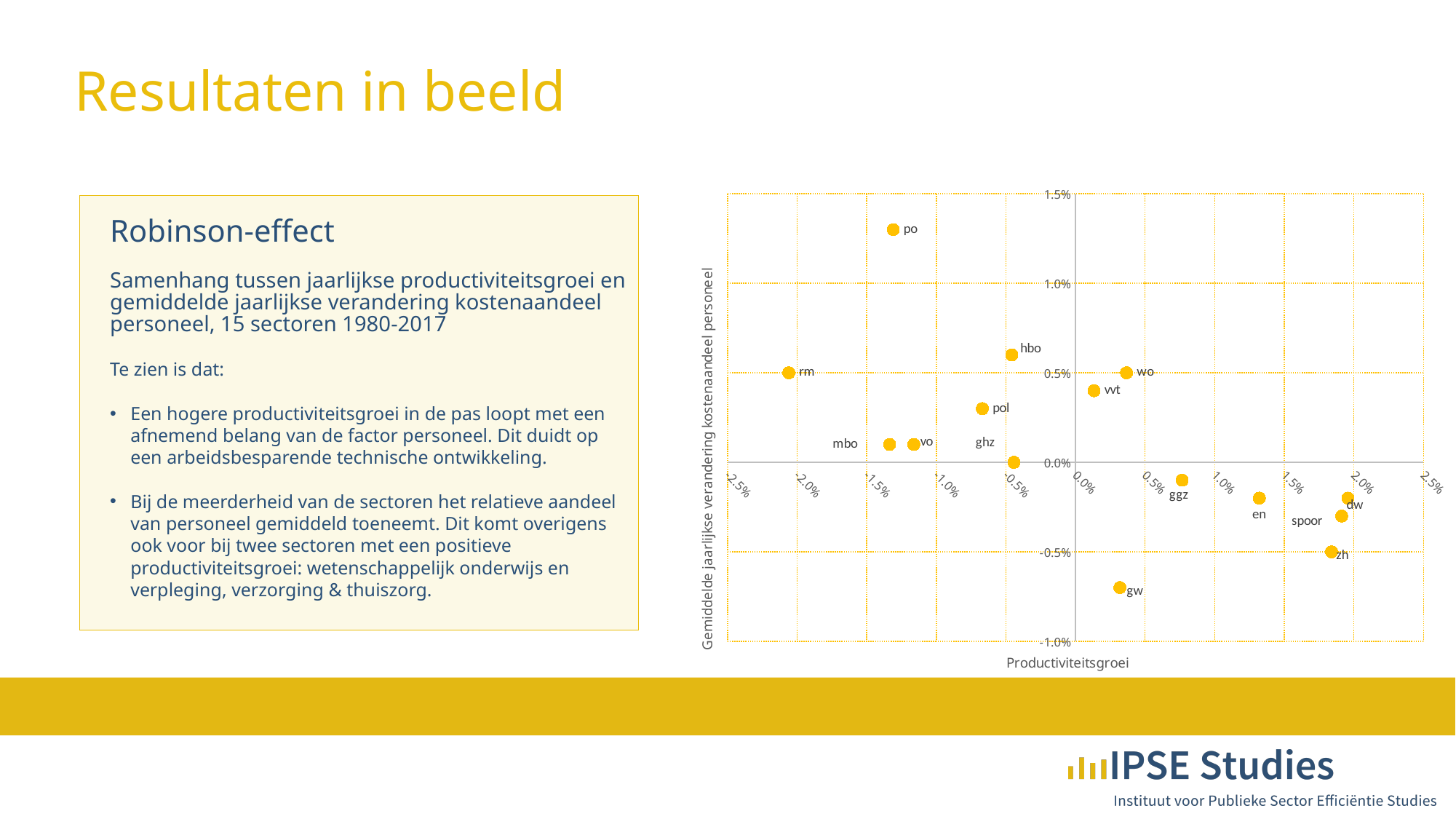
Is the vertical-axis value for gw greater or less than -0.5%? less Which sector has the highest value on the vertical axis (Gemiddelde jaarlijkse verandering kostenaandeel personeel)? po Is the productivity growth (horizontal axis) for zh greater or less than 1.5%? greater Is the productivity growth (horizontal axis) for rm greater or less than -1.5%? less Which sector has the lowest value on the vertical axis? gw Which sector has a higher productivity growth, rm or zh? zh How many data points (sectors) are plotted in the chart? 15 Which sector has a higher vertical-axis value, po or hbo? po Which sector has the lowest productivity growth (leftmost on the horizontal axis)? rm What is the title of the horizontal axis of the chart? Productiviteitsgroei What kind of chart is shown on the slide? scatter chart